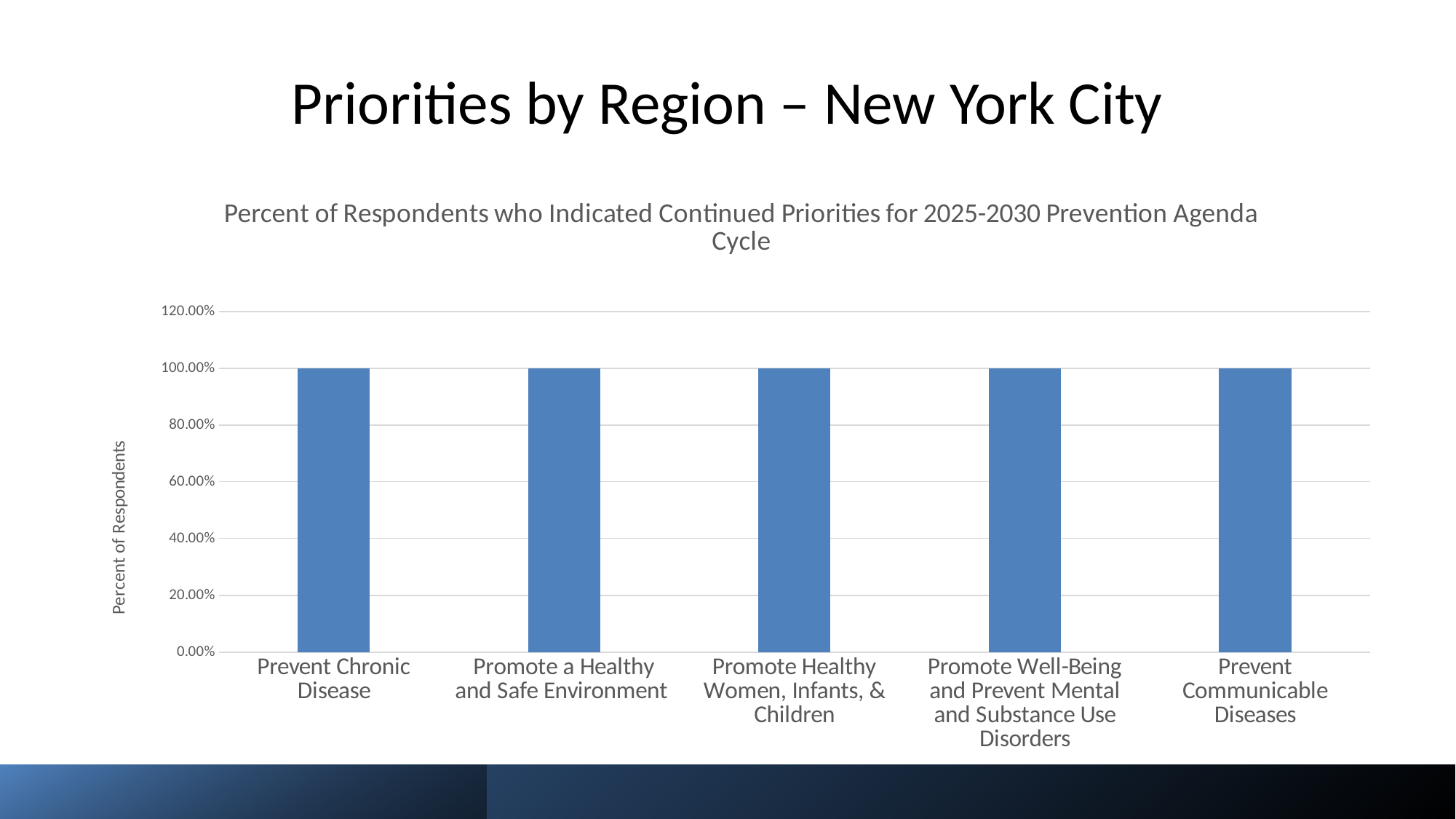
Is the value for Prevent Communicable Diseases greater or less than 80.00%? greater What is the value for Promote Healthy Women, Infants, & Children? 100.00% What is the value for Promote a Healthy and Safe Environment? 100.00% What kind of chart is shown on the slide? bar chart What is the value for Prevent Chronic Disease? 100.00% What is the label on the vertical axis of the chart? Percent of Respondents Do the values rise, fall, or stay the same across the categories from left to right? stay the same What is the value for Prevent Communicable Diseases? 100.00% Is the value for Prevent Chronic Disease greater or less than 120.00%? less How many categories are shown on the x axis of the chart? 5 What is the value for Promote Well-Being and Prevent Mental and Substance Use Disorders? 100.00% What is the title of the chart? Percent of Respondents who Indicated Continued Priorities for 2025-2030 Prevention Agenda Cycle